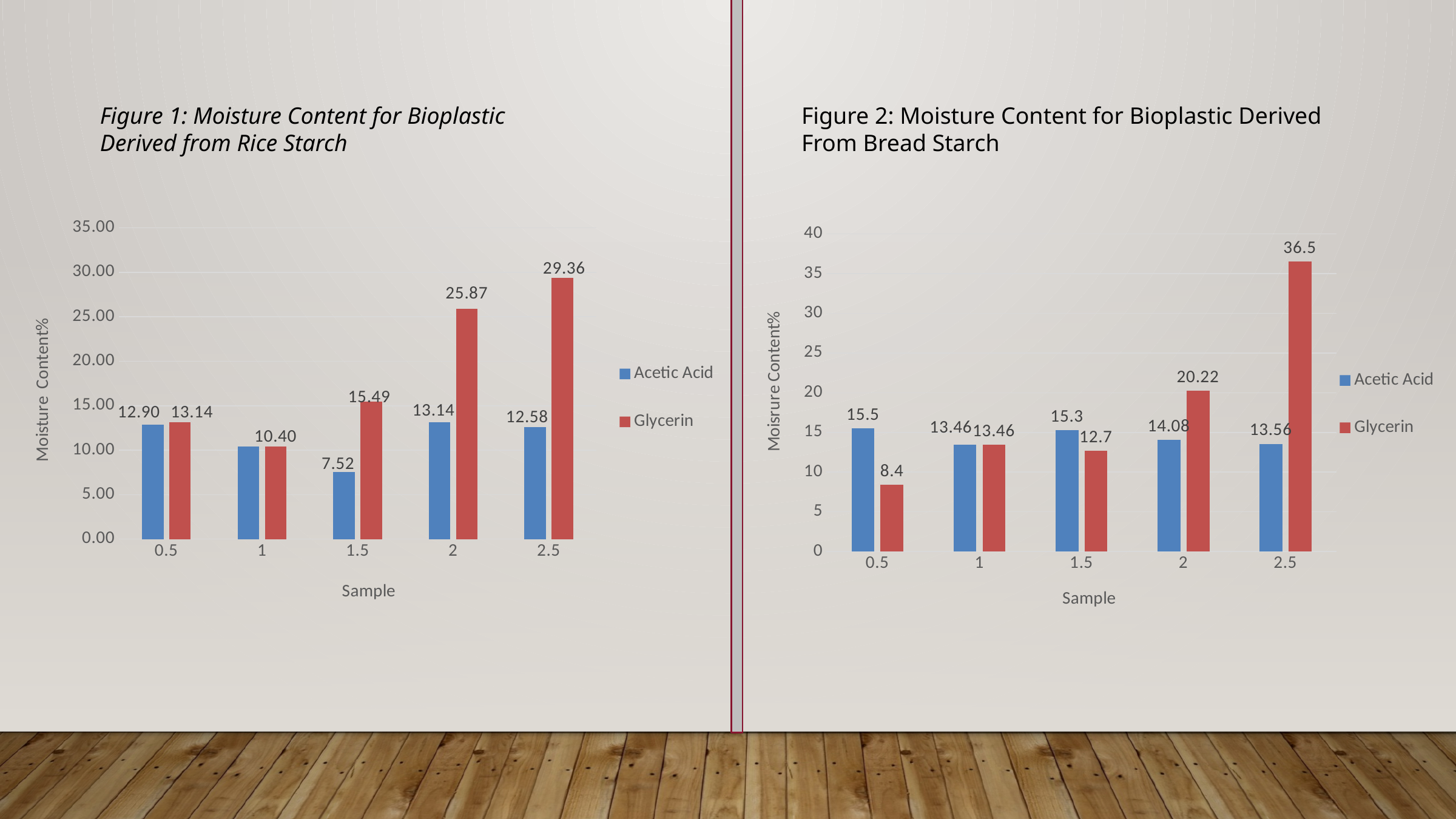
In Figure 1 (Rice Starch), what is the difference between the Glycerin and Acetic Acid values for sample 2? 12.73 In Figure 1 (Rice Starch), what is the Glycerin value for sample 2.5? 29.36 In Figure 1 (Rice Starch), what is the Acetic Acid value for sample 1.5? 7.52 In Figure 2 (Bread Starch), what is the Acetic Acid value for sample 0.5? 15.5 In Figure 1 (Rice Starch), which sample has the lowest Acetic Acid value? 1.5 In Figure 2 (Bread Starch), what is the Glycerin value for sample 2.5? 36.5 In Figure 2 (Bread Starch), how many sample categories are shown on the x axis? 5 In Figure 1 (Rice Starch), how many series does the legend list? 2 In Figure 1 (Rice Starch), which sample has the highest Glycerin value? 2.5 In Figure 2 (Bread Starch), which sample has the lowest Glycerin value? 0.5 In Figure 2 (Bread Starch), which is larger for sample 2: Acetic Acid or Glycerin? Glycerin What kind of chart is Figure 2 (Bread Starch)? Bar chart